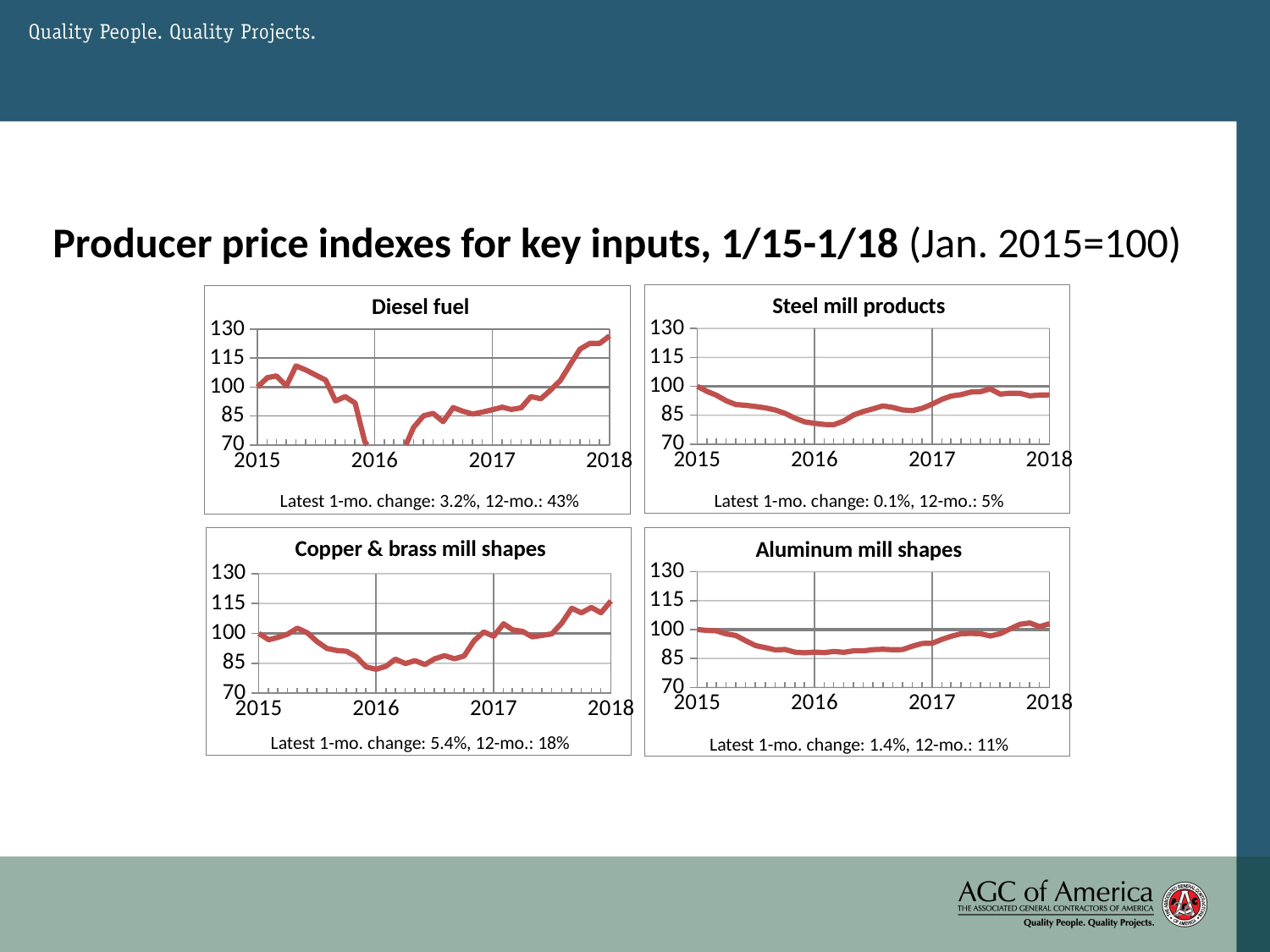
In the Diesel fuel chart, is the value at the start of 2018 greater or less than 115? greater In the Copper & brass mill shapes chart, is the value at the start of 2016 greater or less than 85? less In the Diesel fuel chart, does the index rise or fall between 2017 and 2018? rise In the Diesel fuel chart, what is the latest 12-month change shown? 43% In the Diesel fuel chart, is the value at the start of 2016 greater or less than 85? less Comparing the Diesel fuel chart and the Steel mill products chart, which index is higher at the start of 2018? Diesel fuel How many charts are shown on the slide? 4 In the Steel mill products chart, does the index rise or fall between 2015 and 2016? fall In the Copper & brass mill shapes chart, what is the latest 1-month change shown? 5.4% What kind of chart is the Diesel fuel chart? line chart